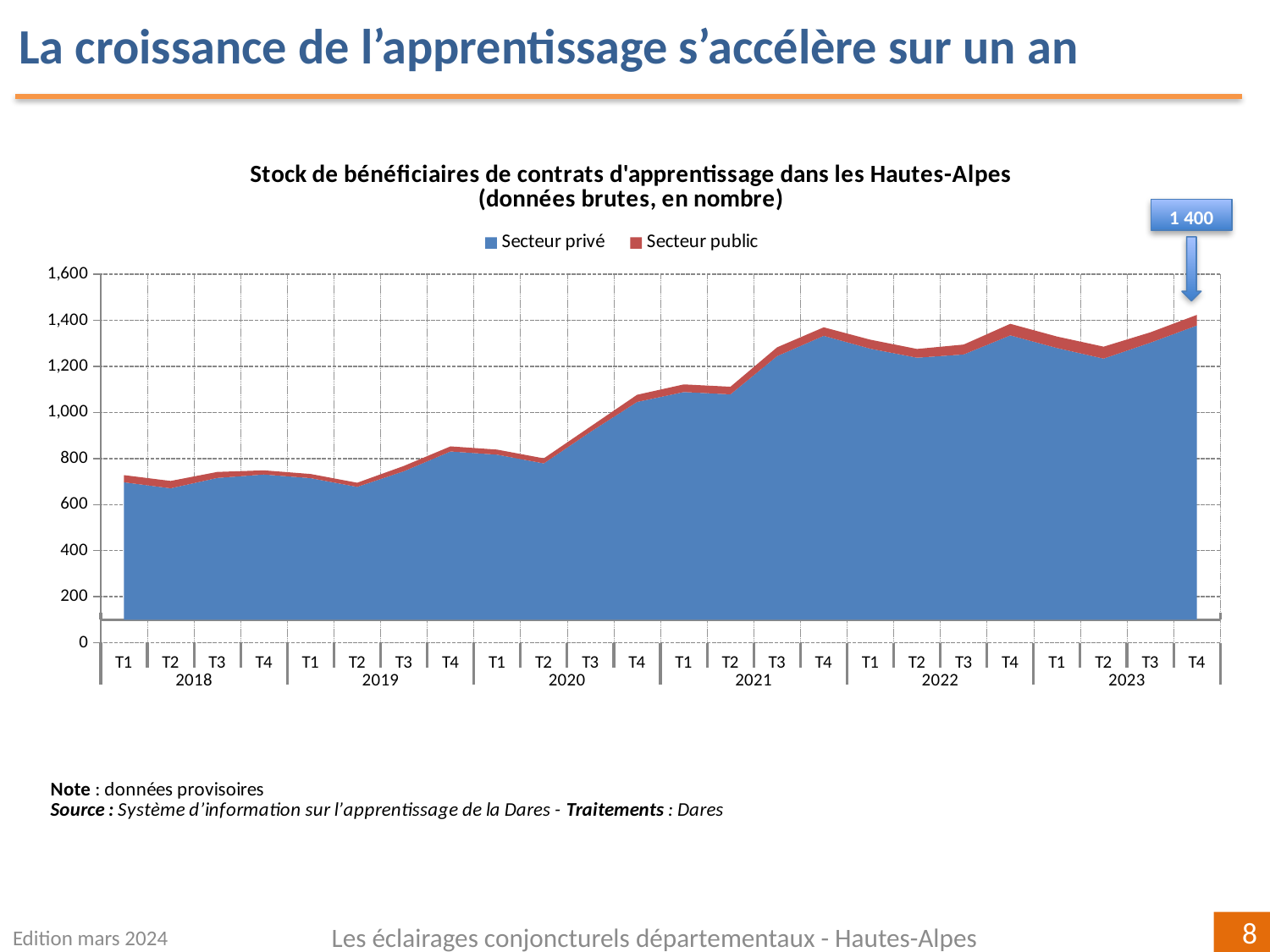
Which series accounts for the larger share of the stock, Secteur privé or Secteur public? Secteur privé What kind of chart is shown on the slide? Area chart Which two series are listed in the legend? Secteur privé and Secteur public Is the total value for T1 2018 greater or less than 800? less Is the total value for T2 2019 greater or less than 800? less What total value is labelled for T4 2023? 1 400 How many quarterly points are plotted along the x axis? 24 How many series does the legend list? 2 Is the total value for T4 2021 greater or less than 1,200? greater Overall, do the values rise or fall from 2018 to 2023? rise Which is larger, the total for T4 2023 or the total for T1 2018? T4 2023